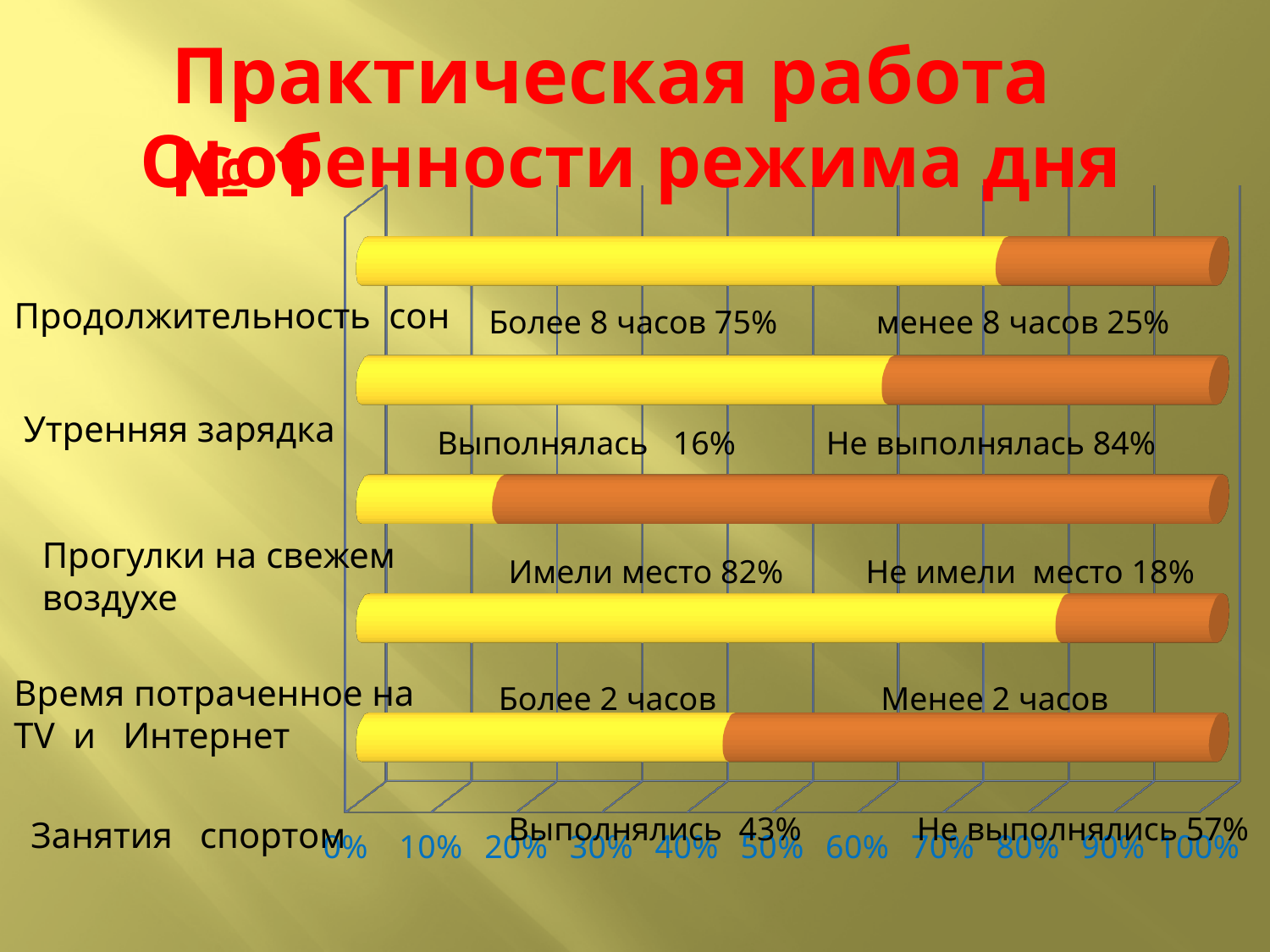
Which is larger for Занятия спортом: 'Выполнялись' or 'Не выполнялись'? Не выполнялись What percentage is given for 'Выполнялась' under Утренняя зарядка? 16% What percentage is labelled 'Более 8 часов' for Продолжительность сна? 75% What is the maximum value shown on the horizontal axis? 100% How many categories (rows) does the chart show? 5 What percentage is given for 'Не имели место' under Прогулки на свежем воздухе? 18% Which has the higher printed value: 'Имели место' for Прогулки на свежем воздухе or 'Более 8 часов' for Продолжительность сна? Имели место (82%) What percentage is given for 'Не выполнялись' under Занятия спортом? 57% What percentage is labelled 'менее 8 часов' for Продолжительность сна? 25% What is the highest percentage value printed on the chart? 84% What is the difference between 'Не выполнялась' and 'Выполнялась' for Утренняя зарядка? 68% What type of chart is shown on the slide? bar chart